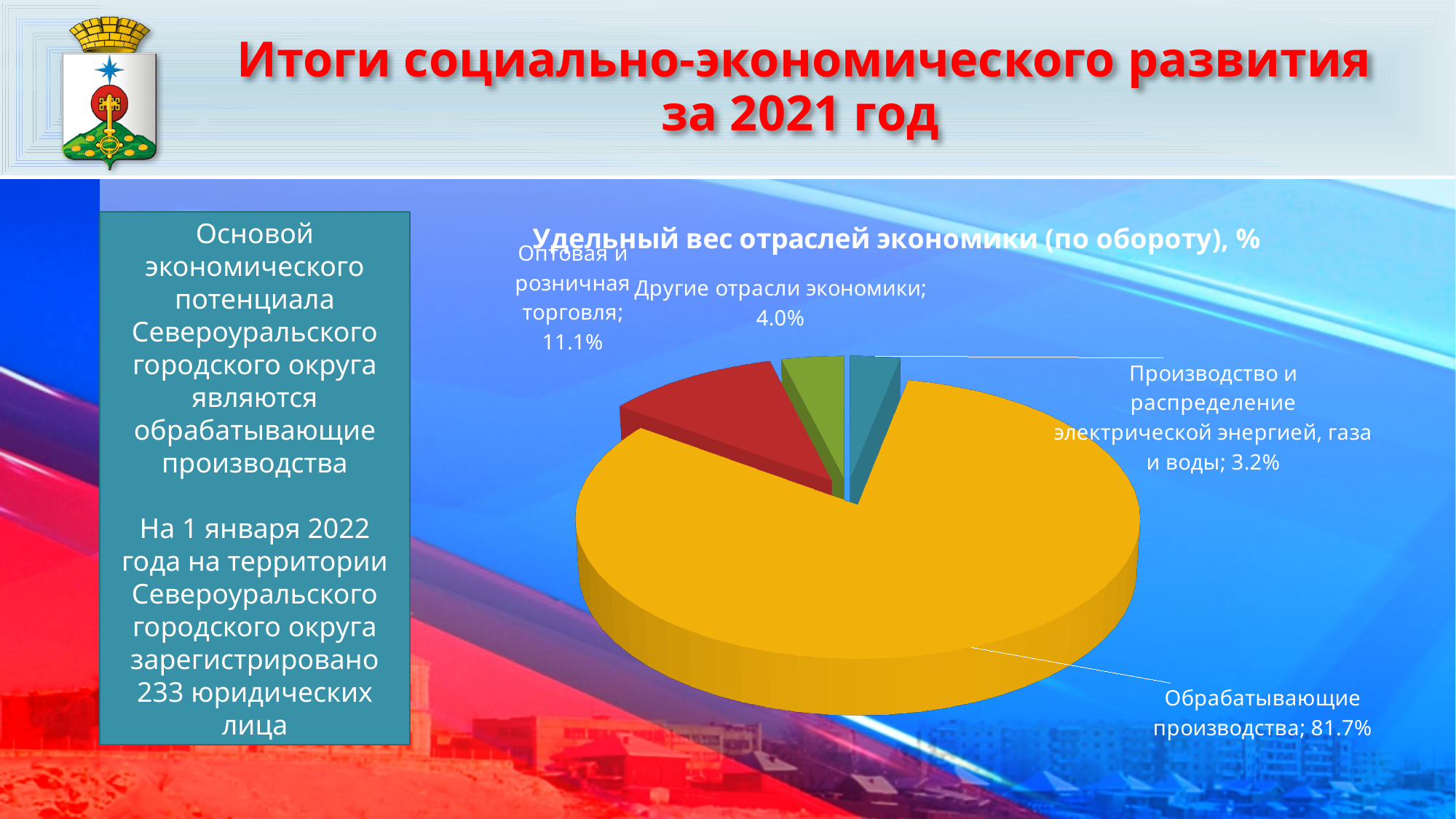
Which sector has the largest share in the pie chart? Обрабатывающие производства Which sector has the smallest share in the pie chart? Производство и распределение электрической энергией, газа и воды What share does Производство и распределение электрической энергией, газа и воды have in the pie chart? 3.2% What colour is the slice for Обрабатывающие производства? Yellow What share does Другие отрасли экономики have in the pie chart? 4.0% What type of chart is shown on the slide? Pie chart How many slices does the pie chart have? 4 What share does Обрабатывающие производства have in the pie chart? 81.7% Which has a larger share: Другие отрасли экономики or Производство и распределение электрической энергией, газа и воды? Другие отрасли экономики What is the difference between the shares of Обрабатывающие производства and Оптовая и розничная торговля? 70.6% What is the title of the chart? Удельный вес отраслей экономики (по обороту), % What share does Оптовая и розничная торговля have in the pie chart? 11.1%